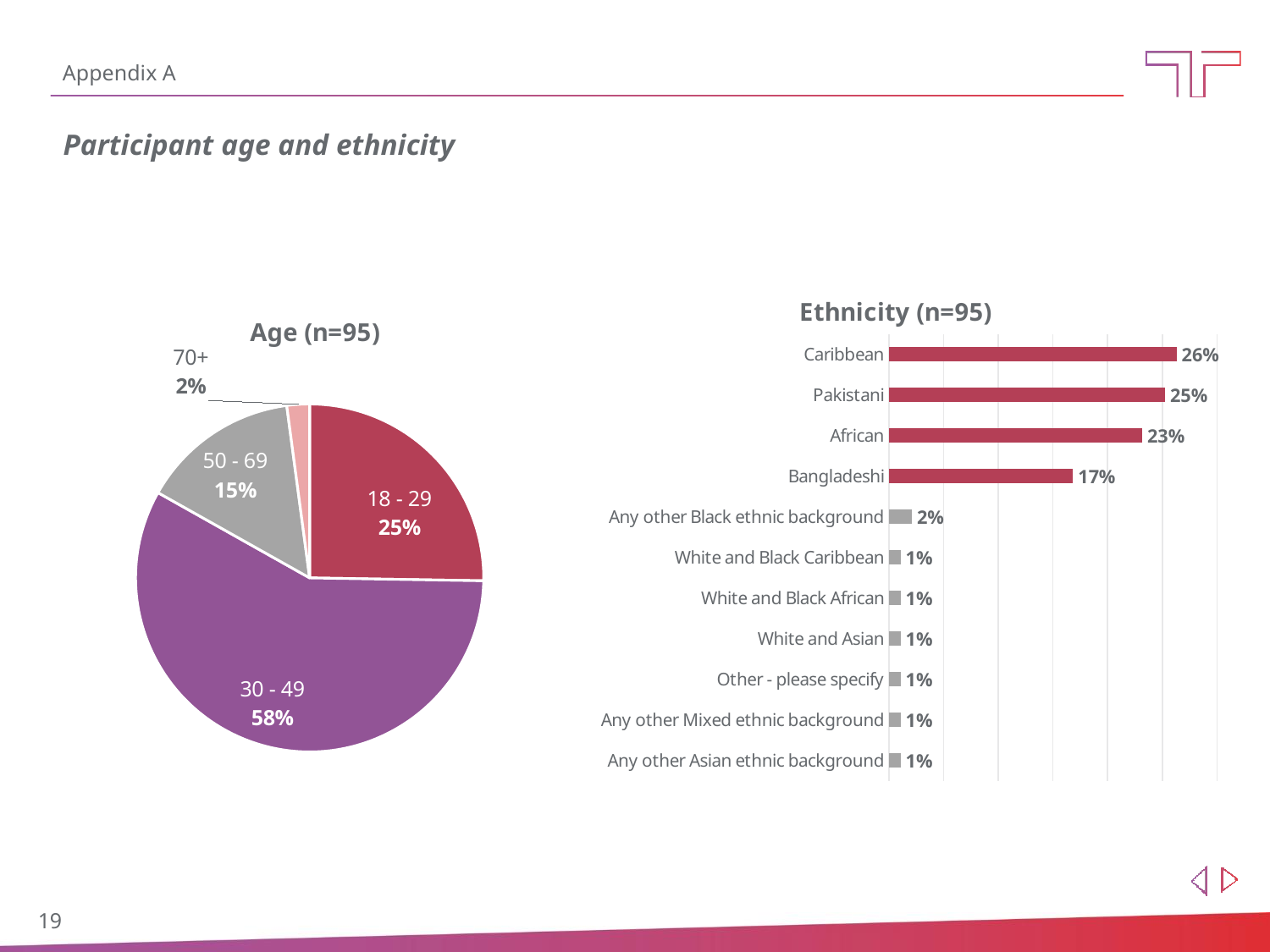
In the Ethnicity (n=95) chart, how many ethnicity categories are listed? 11 In the Ethnicity (n=95) chart, what is the value for Bangladeshi? 17% In the Ethnicity (n=95) chart, which is larger, Pakistani or Bangladeshi? Pakistani In the Age (n=95) chart, which age group has the smallest share? 70+ What kind of chart is the Ethnicity (n=95) chart? Bar chart In the Ethnicity (n=95) chart, what is the difference between Caribbean and African? 3% In the Age (n=95) chart, which age group has the largest share? 30 - 49 What kind of chart is the Age (n=95) chart? Pie chart In the Age (n=95) chart, what share of participants are aged 70+? 2% In the Age (n=95) chart, how many age groups are shown? 4 In the Ethnicity (n=95) chart, which ethnicity has the highest value? Caribbean In the Age (n=95) chart, what share of participants are aged 30 - 49? 58%